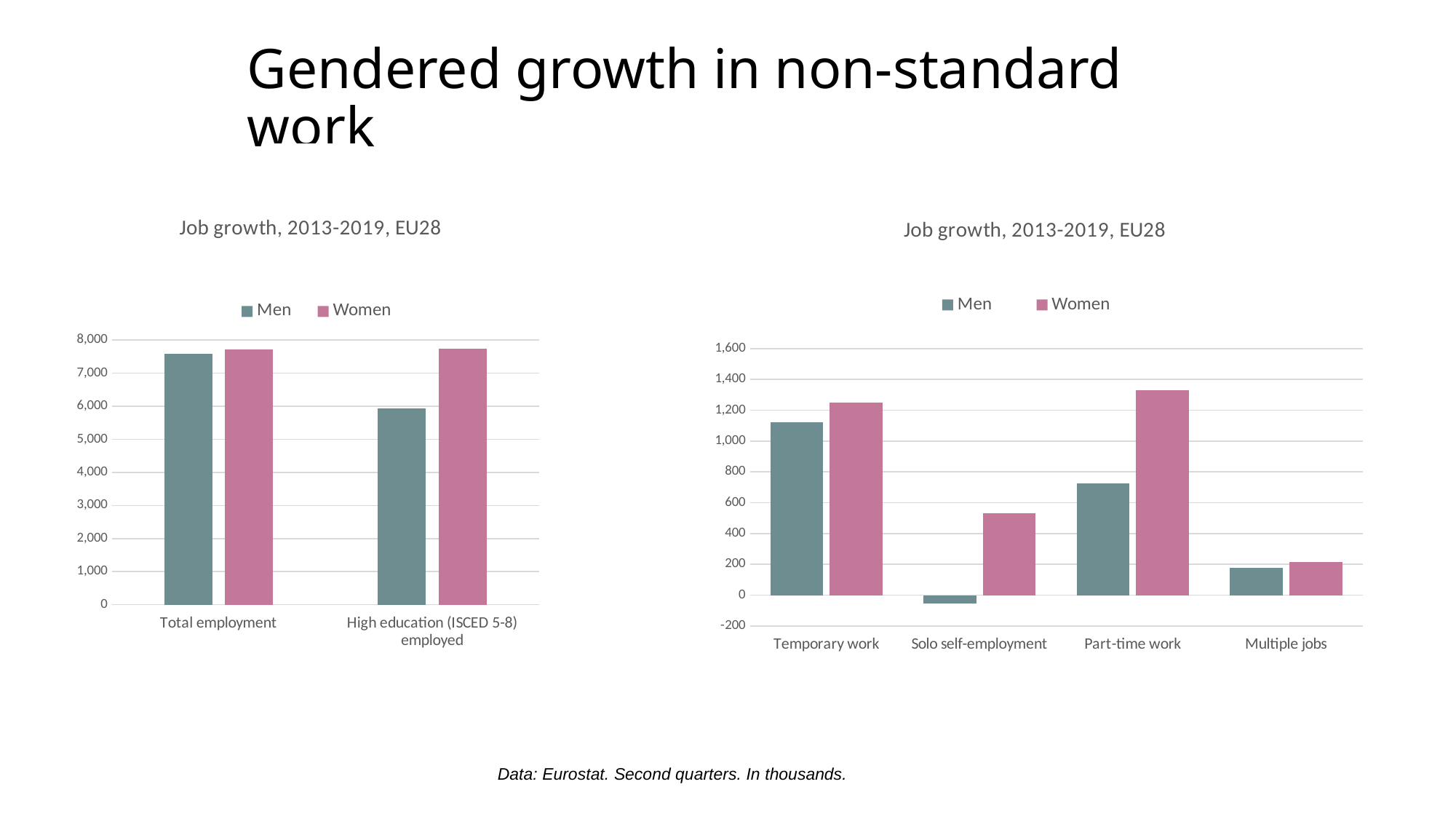
In the right chart, which category has the highest Women value? Part-time work How many series does the legend of the right chart list? 2 How many categories are shown on the x axis of the right chart? 4 What is the title of the right chart? Job growth, 2013-2019, EU28 In the right chart, which is larger for Temporary work, Men or Women? Women What kind of chart is the left chart on the slide? bar chart In the right chart, which category has the lowest Men value? Solo self-employment In the left chart, is the Women value for High education (ISCED 5-8) employed greater or less than 7,000? greater In the left chart, which is larger for High education (ISCED 5-8) employed, Men or Women? Women In the left chart, is the Men value for Total employment greater or less than 7,000? greater In the right chart, is the Men value for Part-time work greater or less than 800? less How many categories are shown on the x axis of the left chart? 2